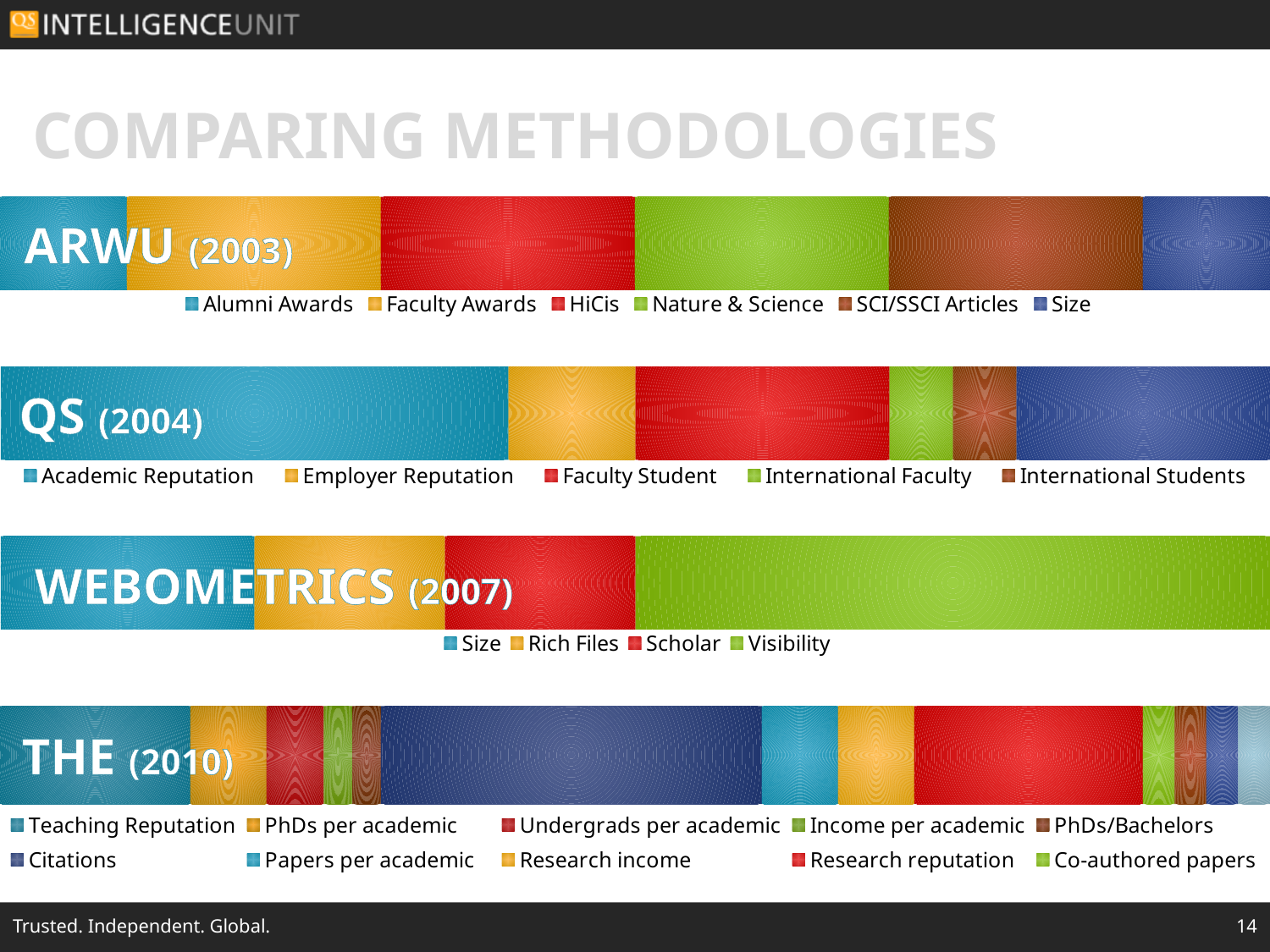
In the THE (2010) chart, which segment is larger: Citations or Teaching Reputation? Citations In the WEBOMETRICS (2007) chart, which segment is larger: Visibility or Rich Files? Visibility In the QS (2004) chart, which segment is larger: Academic Reputation or Employer Reputation? Academic Reputation In the QS (2004) chart, which series has the largest segment? Academic Reputation In the WEBOMETRICS (2007) chart, which series has the largest segment? Visibility What kind of chart is used for the ARWU (2003) row? bar chart How many series does the legend of the QS (2004) chart list? 5 How many series does the legend of the THE (2010) chart list? 10 In the THE (2010) chart, which series has the largest segment? Citations How many series does the legend of the WEBOMETRICS (2007) chart list? 4 Which series is listed first in the legend of the WEBOMETRICS (2007) chart? Size